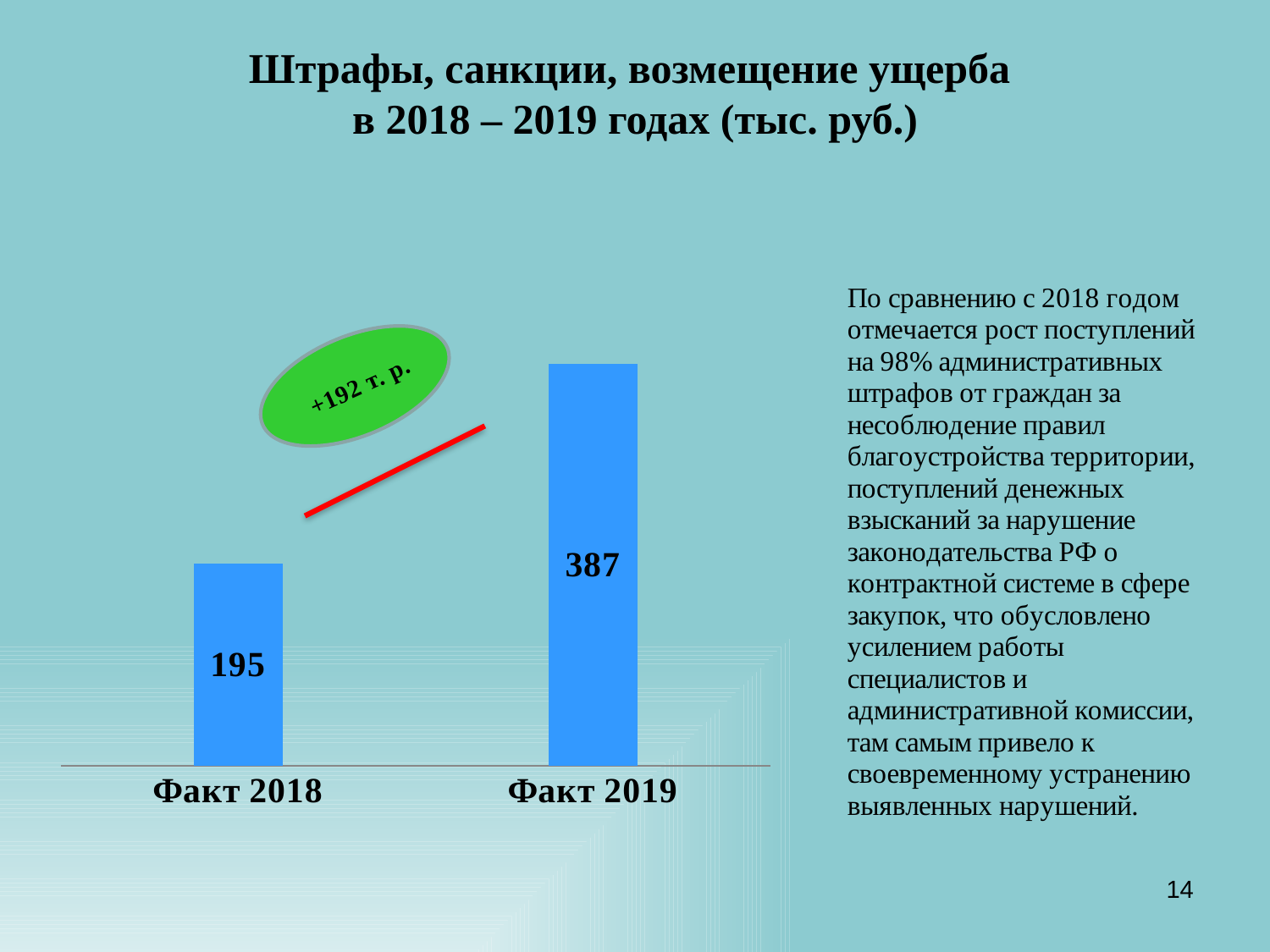
What kind of chart is shown on the slide? bar chart What is the difference between the values for Факт 2019 and Факт 2018? 192 Do the values rise or fall from Факт 2018 to Факт 2019? rise How many categories are shown in the chart? 2 What increase is written in the green oval on the chart? +192 т. р. Which category has the highest value? Факт 2019 Which category has the lowest value? Факт 2018 What is the title of the chart on the slide? Штрафы, санкции, возмещение ущерба в 2018 – 2019 годах (тыс. руб.) Which is larger, the value for Факт 2018 or Факт 2019? Факт 2019 What is the value for Факт 2019? 387 What is the value for Факт 2018? 195